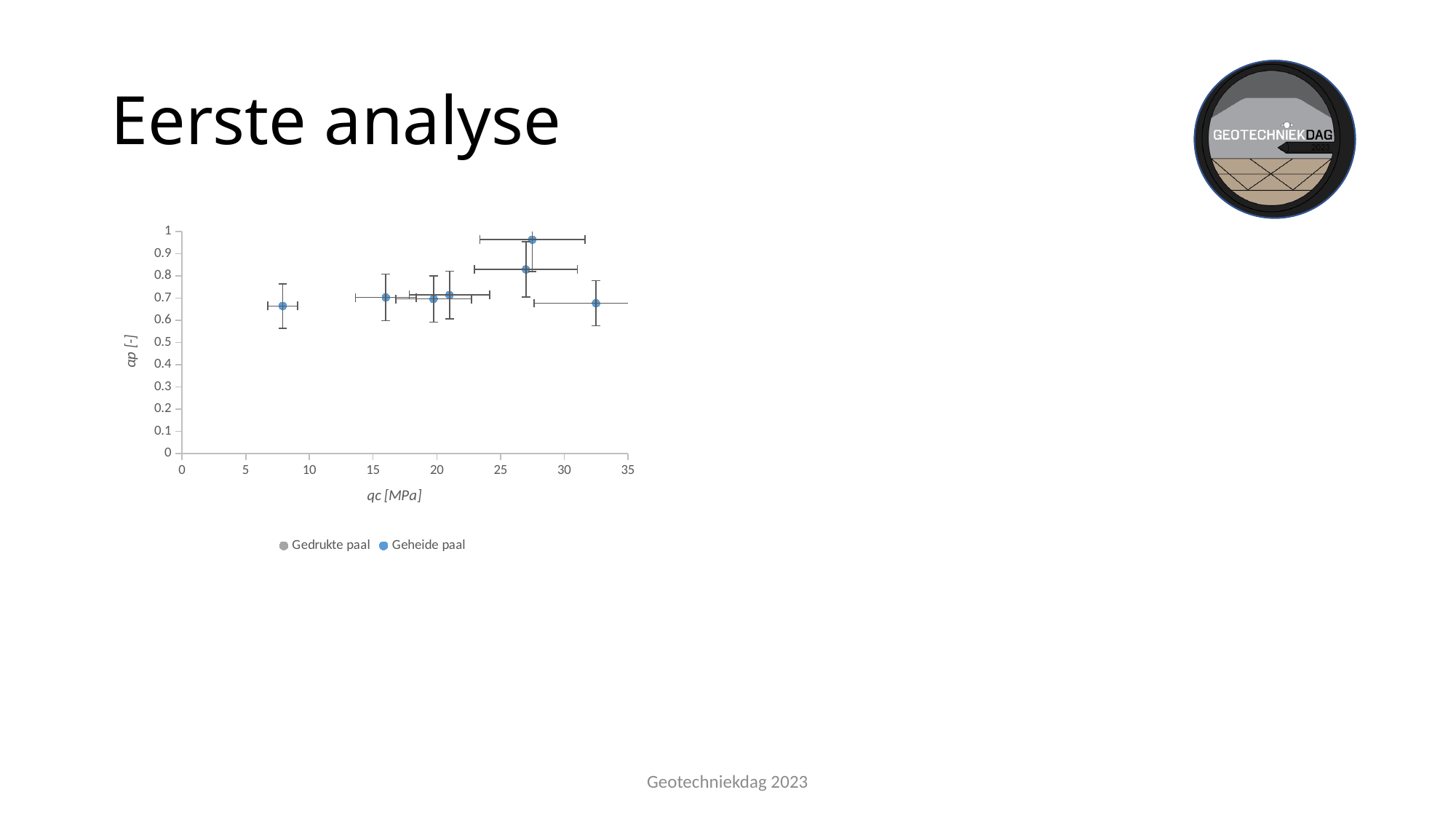
Is the αp value of the point near qc = 32.5 MPa greater or less than 0.8? less Which point has the higher αp: the point near qc = 8 MPa or the point near qc = 27.5 MPa? the point near qc = 27.5 MPa Is the qc value of the leftmost point greater or less than 10 MPa? less How many data points are plotted on the chart? 7 Is the highest αp value on the chart greater or less than 0.9? greater How many series does the legend list? 2 What are the two series named in the legend? Gedrukte paal and Geheide paal What is the label of the x axis? qc [MPa] What kind of chart is shown on the slide? scatter chart